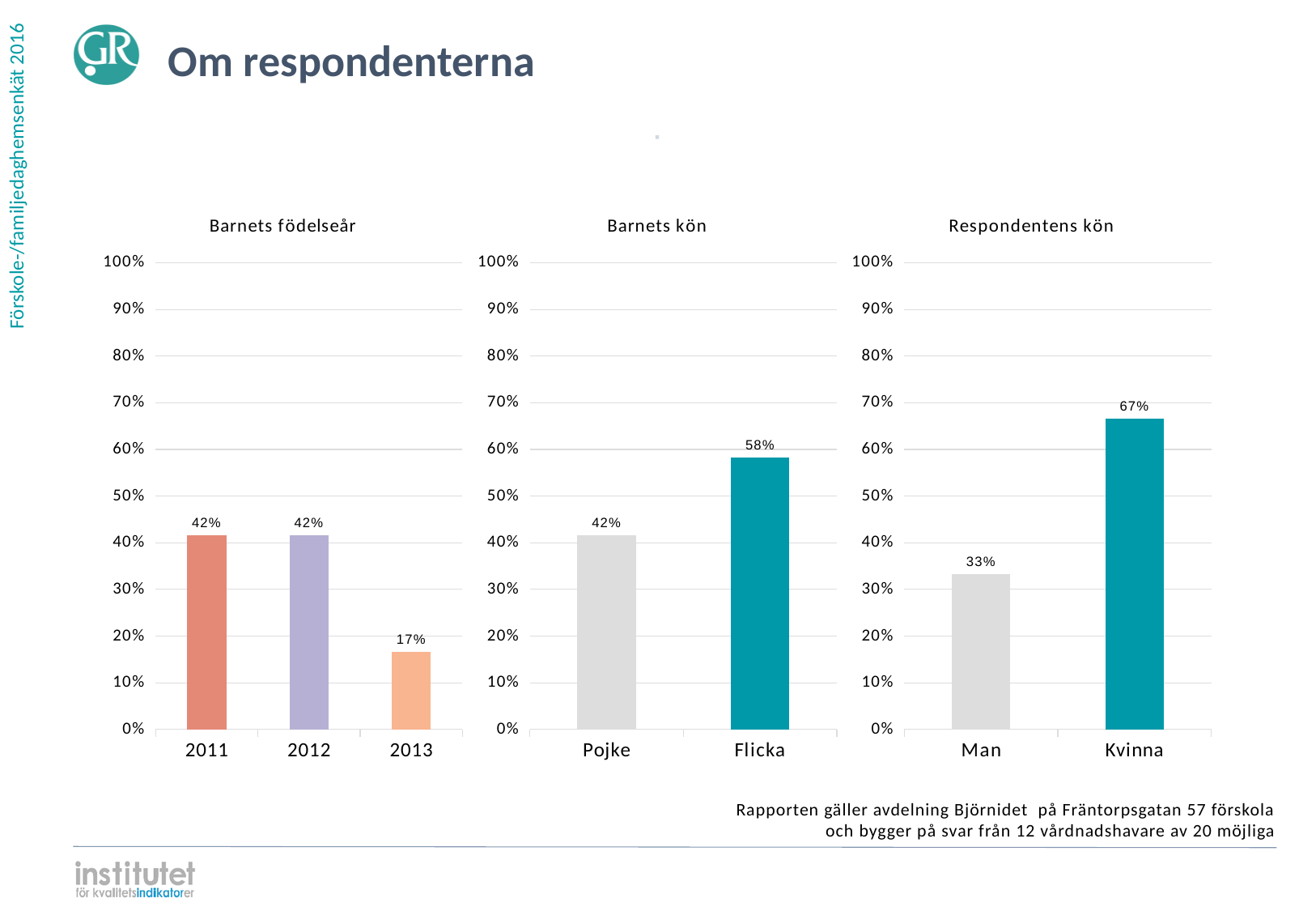
In the 'Barnets födelseår' chart, what is the difference between the values for 2011 and 2013? 25% In the 'Respondentens kön' chart, what is the value for Man? 33% In the 'Barnets födelseår' chart, what is the value for 2013? 17% In the 'Respondentens kön' chart, which is larger, the value for Man or the value for Kvinna? Kvinna In the 'Respondentens kön' chart, is the value for Kvinna greater or less than 60%? greater In the 'Barnets kön' chart, what is the difference between the values for Flicka and Pojke? 16% In the 'Barnets födelseår' chart, which category has the lowest value? 2013 In the 'Barnets kön' chart, which category has the highest value? Flicka What is the title of the leftmost chart on the slide? Barnets födelseår In the 'Barnets födelseår' chart, how many categories are shown on the x axis? 3 In the 'Barnets kön' chart, what is the value for Flicka? 58% What kind of chart is the 'Respondentens kön' chart? Bar chart